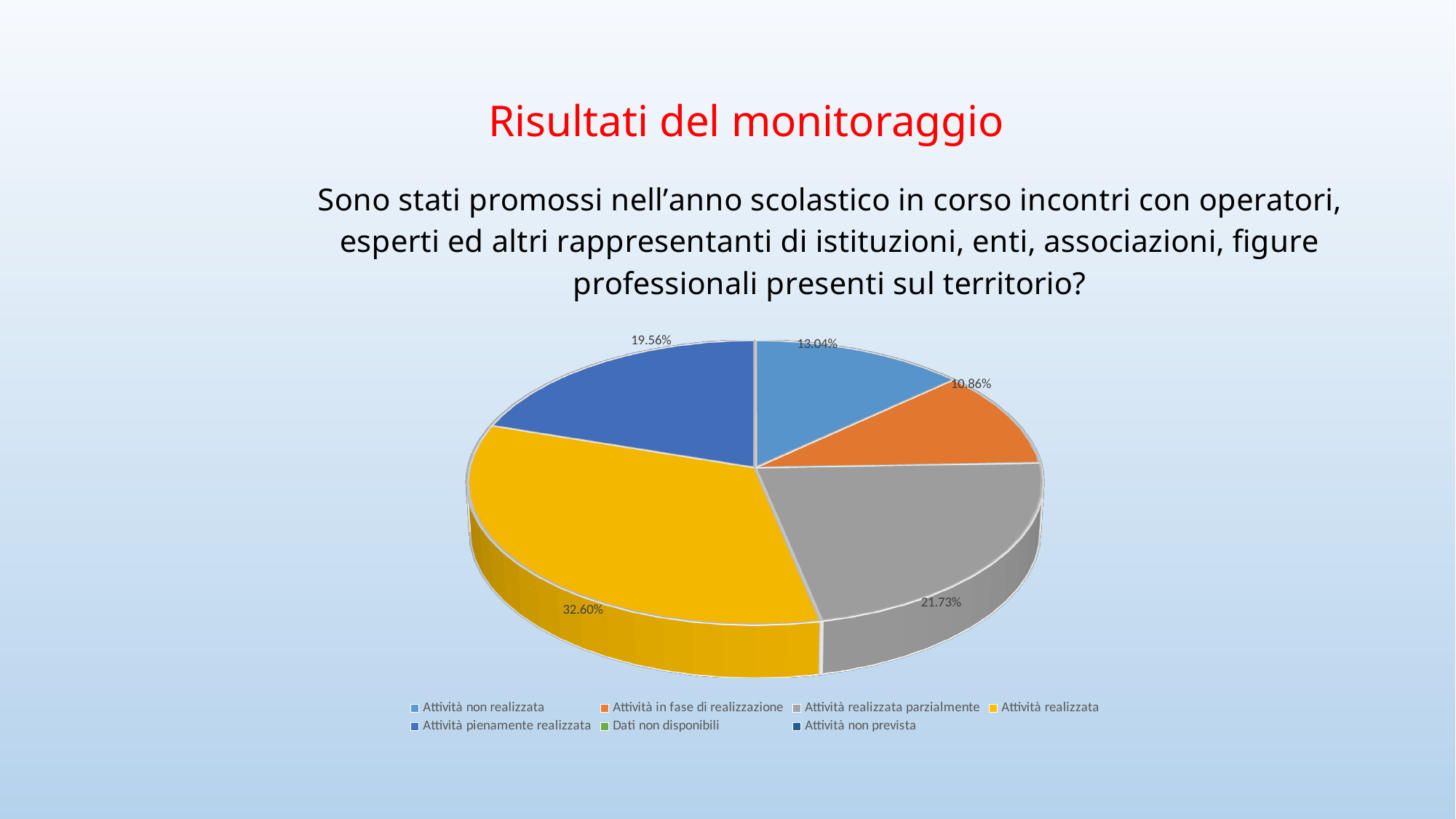
Which category has the largest slice of the pie? Attività realizzata What is the difference in percentage points between "Attività realizzata" and "Attività realizzata parzialmente"? 10.87 Which is larger: "Attività realizzata parzialmente" or "Attività pienamente realizzata"? Attività realizzata parzialmente What kind of chart is shown on the slide? pie chart Which of the labelled slices is the smallest? Attività in fase di realizzazione What percentage is shown for "Attività pienamente realizzata"? 19.56% What percentage is shown for "Attività non realizzata"? 13.04% What percentage is shown for "Attività realizzata"? 32.60% What percentage is shown for "Attività in fase di realizzazione"? 10.86% What colour is the slice for "Attività realizzata"? yellow How many entries does the legend list? 7 What percentage is shown for "Attività realizzata parzialmente"? 21.73%